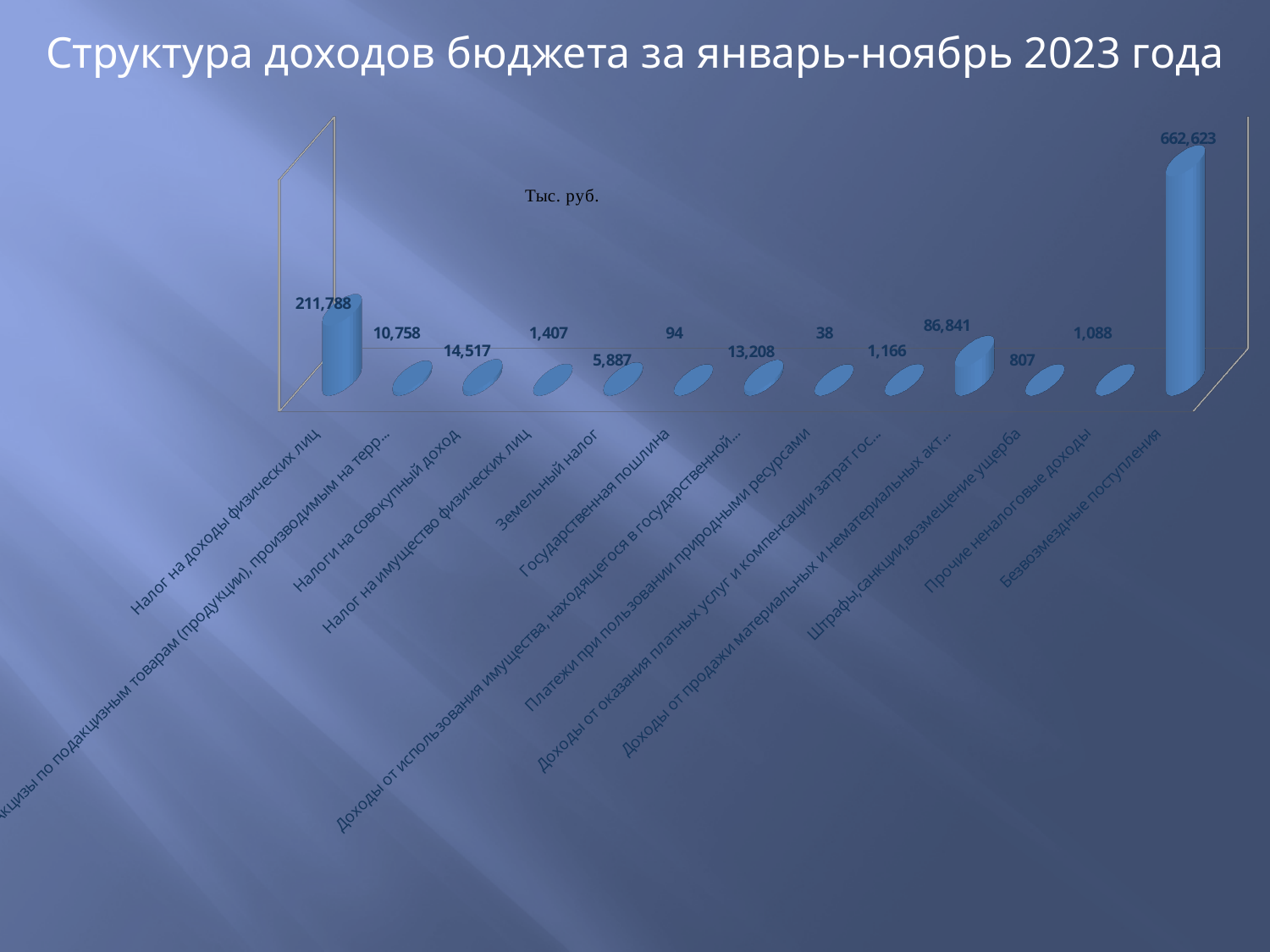
What is the value for Налог на доходы физических лиц? 211,788 Which is larger: Налоги на совокупный доход or Штрафы, санкции, возмещение ущерба? Налоги на совокупный доход What is the value for Государственная пошлина? 94 Which category has the lowest value? Платежи при пользовании природными ресурсами What is the value for Безвозмездные поступления? 662,623 What is the value for Земельный налог? 5,887 Which category has the highest value? Безвозмездные поступления What kind of chart is shown on the slide? Bar chart What unit is indicated on the chart? Тыс. руб. How many categories are shown in the chart? 13 What is the value for Платежи при пользовании природными ресурсами? 38 What is the difference between Безвозмездные поступления and Налог на доходы физических лиц? 450,835